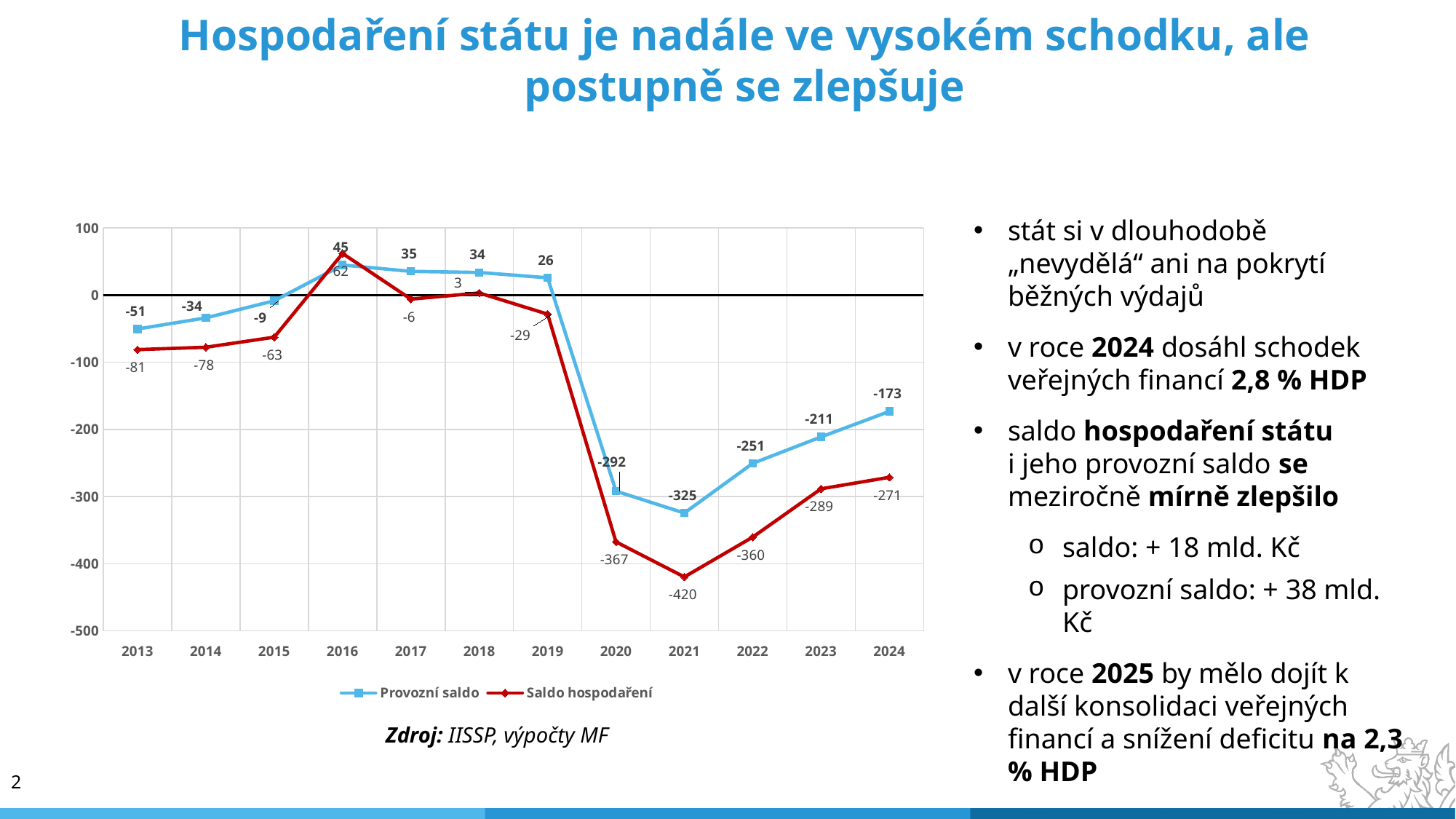
Which series has the higher value in 2020, Provozní saldo or Saldo hospodaření? Provozní saldo How many years are shown on the x axis? 12 What is the value of Saldo hospodaření in 2021? -420 What is the source given below the chart? IISSP, výpočty MF What is the value of Provozní saldo in 2024? -173 In which year is Saldo hospodaření at its lowest? 2021 What kind of chart is shown on the slide? line chart How many series does the legend list? 2 Does Provozní saldo rise or fall from 2021 to 2024? rise In which year is Provozní saldo at its highest? 2016 What is the difference between Provozní saldo and Saldo hospodaření in 2024? 98 What is the value of Saldo hospodaření in 2016? 62